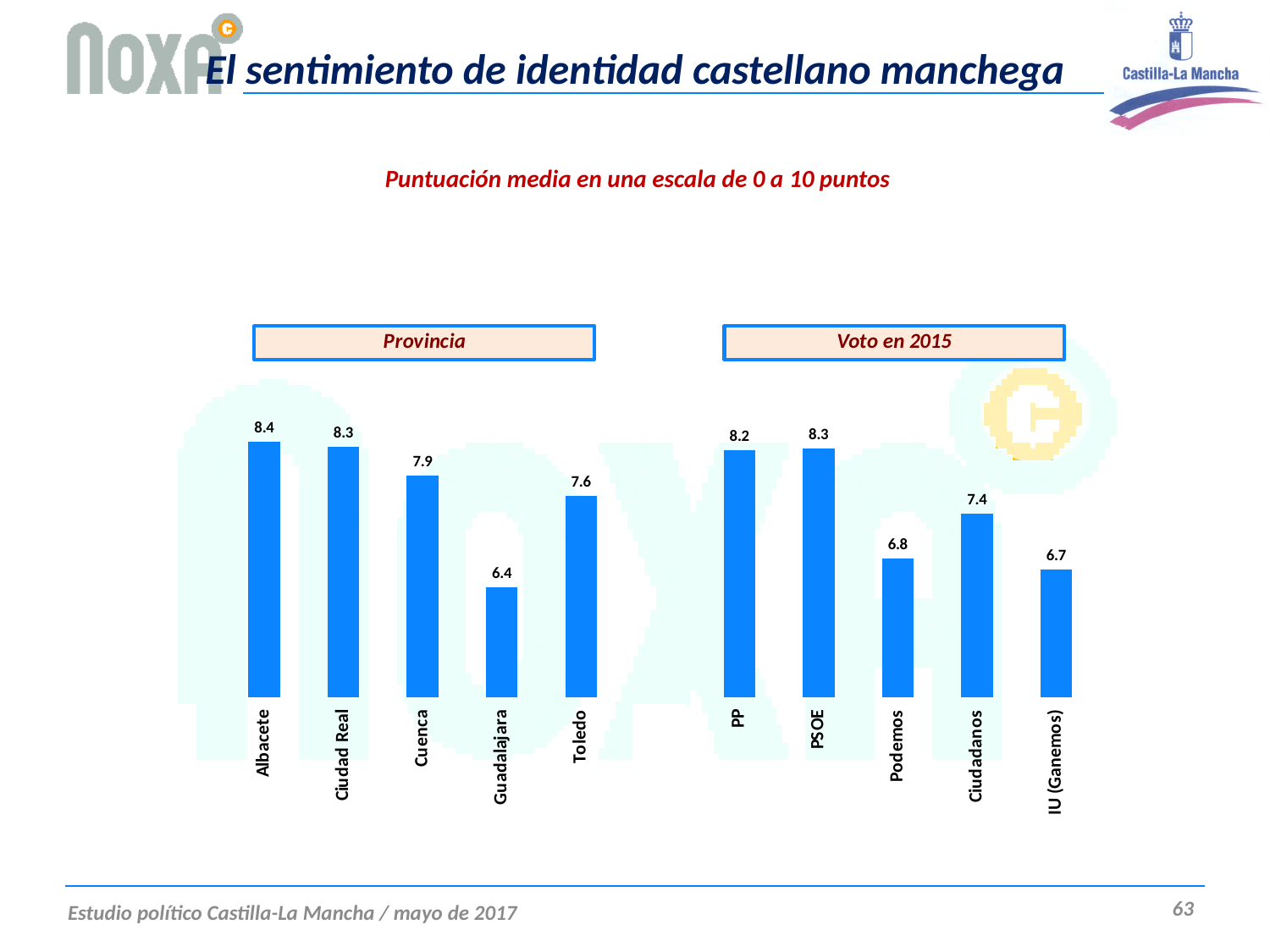
In the Provincia chart, what is the value for Albacete? 8.4 In the Voto en 2015 chart, what is the difference between PSOE and Podemos? 1.5 In the Voto en 2015 chart, which party has the highest value? PSOE In the Provincia chart, what is the value for Toledo? 7.6 In the Voto en 2015 chart, what is the value for Ciudadanos? 7.4 In the Provincia chart, how many provinces are shown? 5 In the Voto en 2015 chart, which party has the lowest value? IU (Ganemos) In the Voto en 2015 chart, which is larger, the value for PP or the value for Ciudadanos? PP What is the subtitle describing the scale used in the charts? Puntuación media en una escala de 0 a 10 puntos What kind of chart is the Voto en 2015 chart? Bar chart In the Provincia chart, which province has the lowest value? Guadalajara In the Provincia chart, what is the difference between Albacete and Guadalajara? 2.0